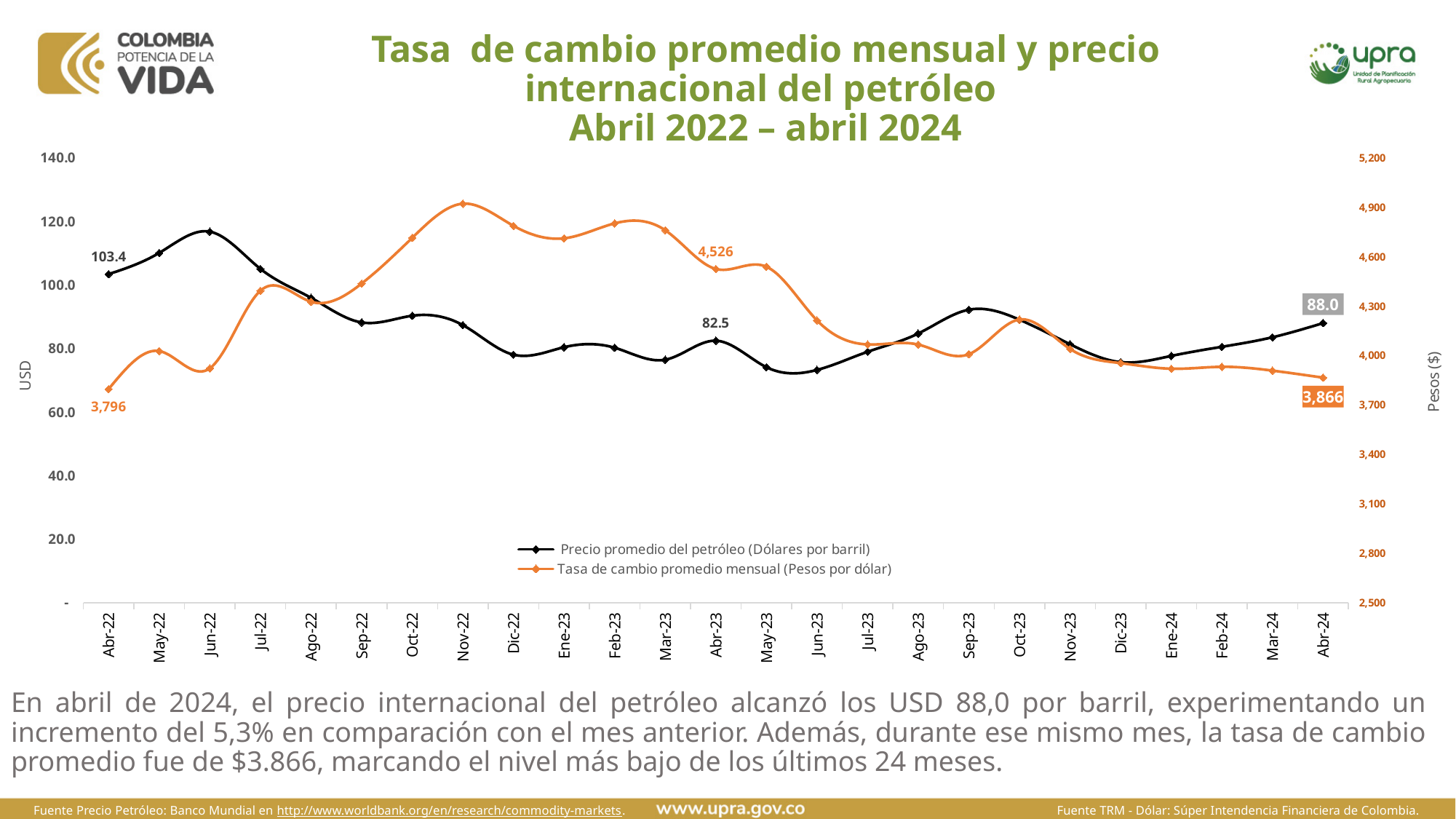
In which month did the average monthly exchange rate reach its highest value? Nov-22 Which month had a higher average oil price, Abr-22 or Abr-24? Abr-22 What was the average oil price in Abr-24? 88.0 What was the average oil price (Dólares por barril) in Abr-22? 103.4 In which month did the average oil price reach its highest value? Jun-22 What was the average monthly exchange rate in Abr-23? 4,526 What was the average monthly exchange rate (Pesos por dólar) in Abr-24? 3,866 What is the difference between the exchange rate in Abr-23 and in Abr-24? 660 Is the average oil price in Jun-22 greater or less than 100.0? greater What type of chart is shown on the slide? Line chart How many months are shown on the x axis? 25 What is the difference between the oil price in Abr-22 and in Abr-23? 20.9